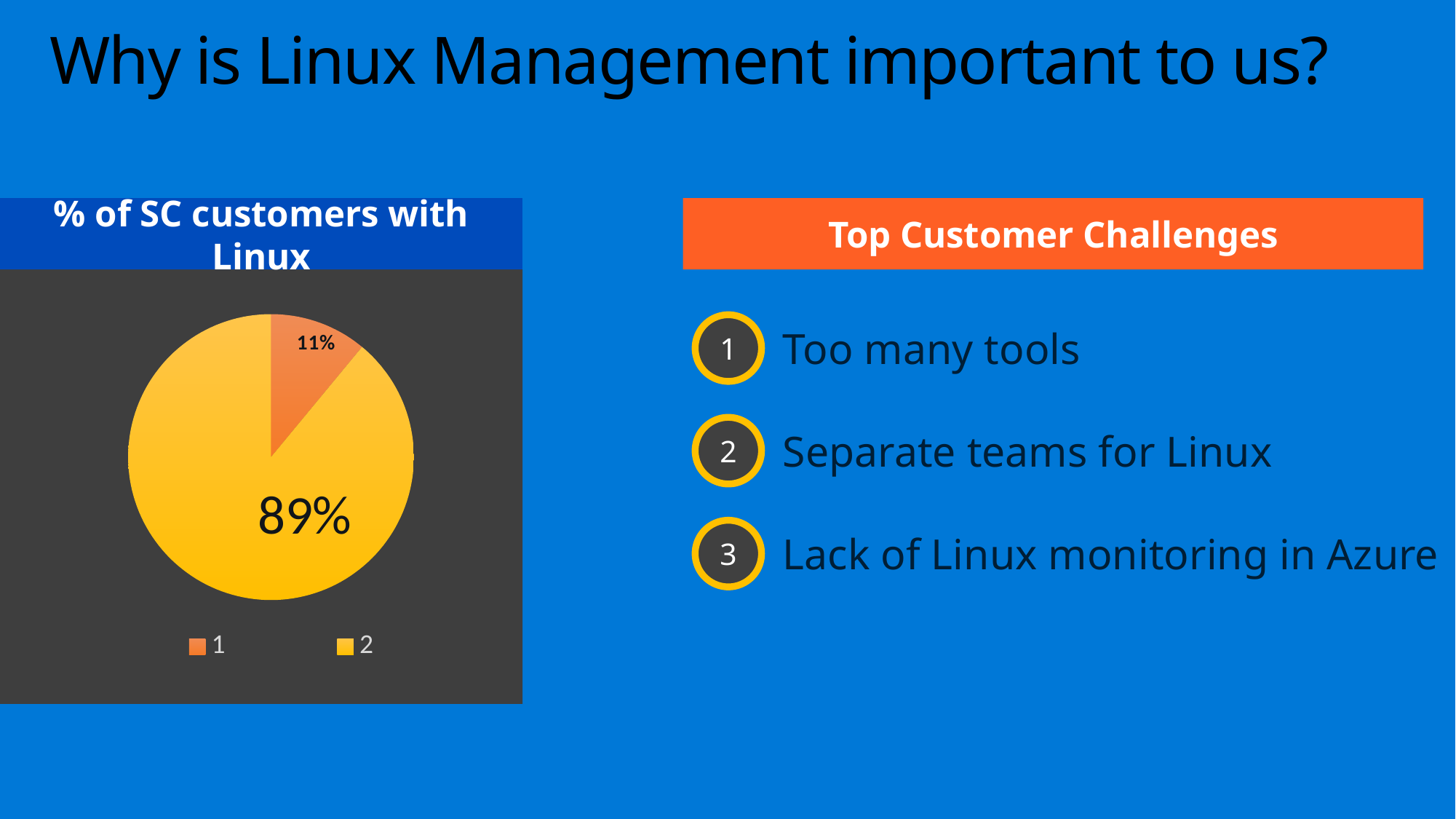
What share of the pie does slice 1 represent? 11% What is the difference in percentage points between slice 2 and slice 1? 78 Which is larger, slice 1 or slice 2? 2 Which slice is the smallest in the pie chart? 1 How many slices does the pie chart have? 2 What colour is slice 1 in the pie chart? orange Which slice is the largest in the pie chart? 2 How many entries does the legend list? 2 What is the title of the chart? % of SC customers with Linux What share of the pie does slice 2 represent? 89% What kind of chart is shown on the slide? pie chart